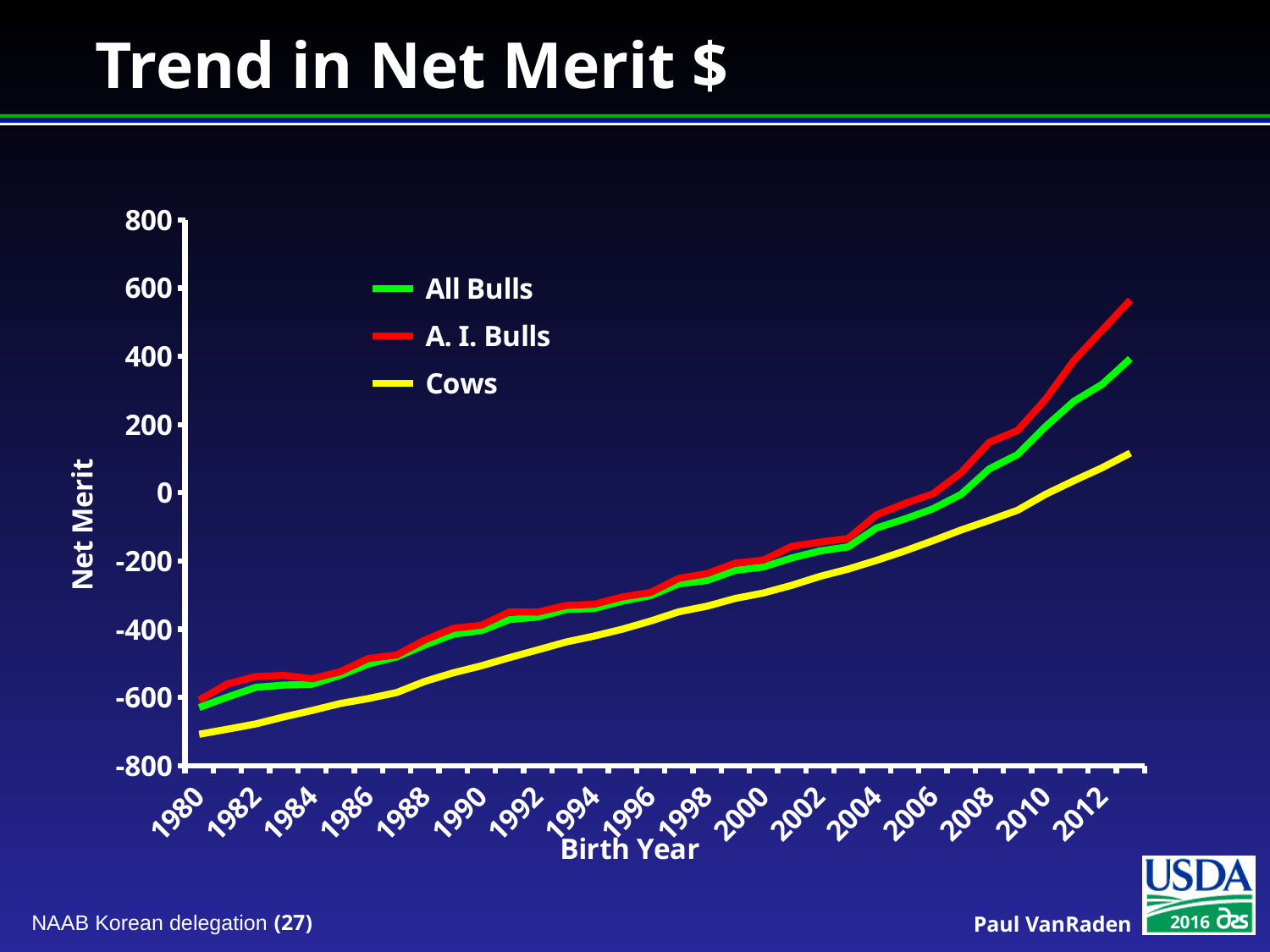
Which series has the highest Net Merit at birth year 2012? A. I. Bulls Is the Net Merit value for Cows at birth year 2006 greater or less than 0? less Is the Net Merit value for All Bulls at birth year 2012 greater or less than 200? greater What is the title of the chart? Trend in Net Merit $ At birth year 1990, which series has the larger Net Merit, All Bulls or Cows? All Bulls Do the Net Merit values for A. I. Bulls rise or fall as birth year increases from 1980 to 2012? rise What colour is the line for Cows? yellow Which series has the lowest Net Merit at birth year 2012? Cows Is the Net Merit value for Cows at birth year 2000 greater or less than -200? less How many series does the legend list? 3 What kind of chart is shown on the slide? line chart